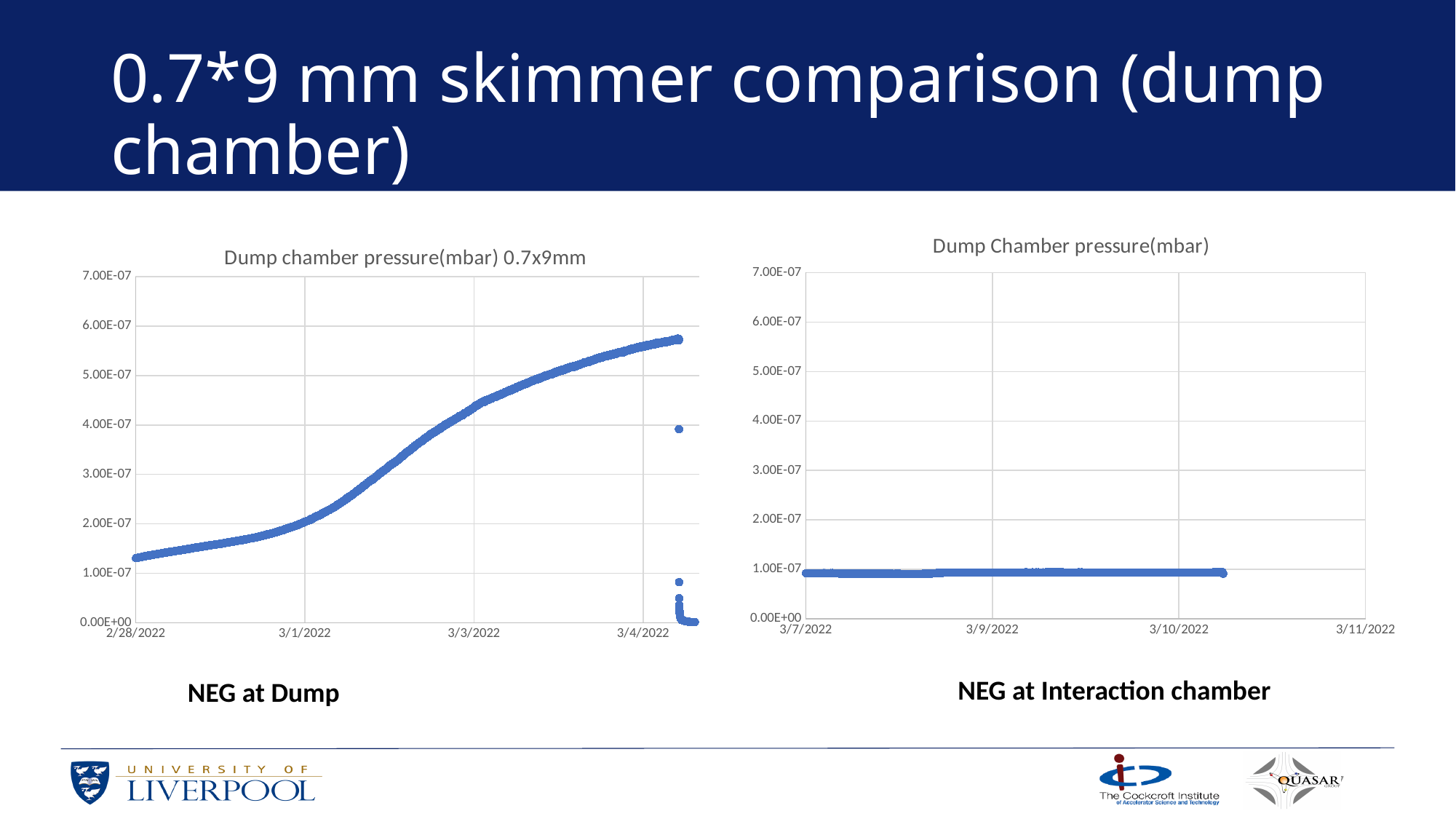
In the right chart (Dump Chamber pressure(mbar)), is the pressure on 3/9/2022 greater or less than 2.00E-07? less What is the title of the chart on the left of the slide? Dump chamber pressure(mbar) 0.7x9mm What is the title of the chart on the right of the slide? Dump Chamber pressure(mbar) In the left chart (Dump chamber pressure(mbar) 0.7x9mm), is the pressure on 3/1/2022 greater or less than 3.00E-07? less In the left chart (Dump chamber pressure(mbar) 0.7x9mm), what kind of chart is shown? scatter chart In the right chart (Dump Chamber pressure(mbar)), does the pressure rise, fall, or stay roughly flat from 3/7/2022 to 3/10/2022? stay roughly flat In the left chart (Dump chamber pressure(mbar) 0.7x9mm), is the pressure on 3/3/2022 greater or less than 4.00E-07? greater Which chart shows the higher pressure on 3/3/2022 (left chart) compared with 3/9/2022 (right chart)? the left chart (Dump chamber pressure(mbar) 0.7x9mm) What is the maximum value shown on the y axis of the right chart (Dump Chamber pressure(mbar))? 7.00E-07 In the left chart (Dump chamber pressure(mbar) 0.7x9mm), does the pressure rise or fall from 2/28/2022 to 3/4/2022 along the main curve? rise